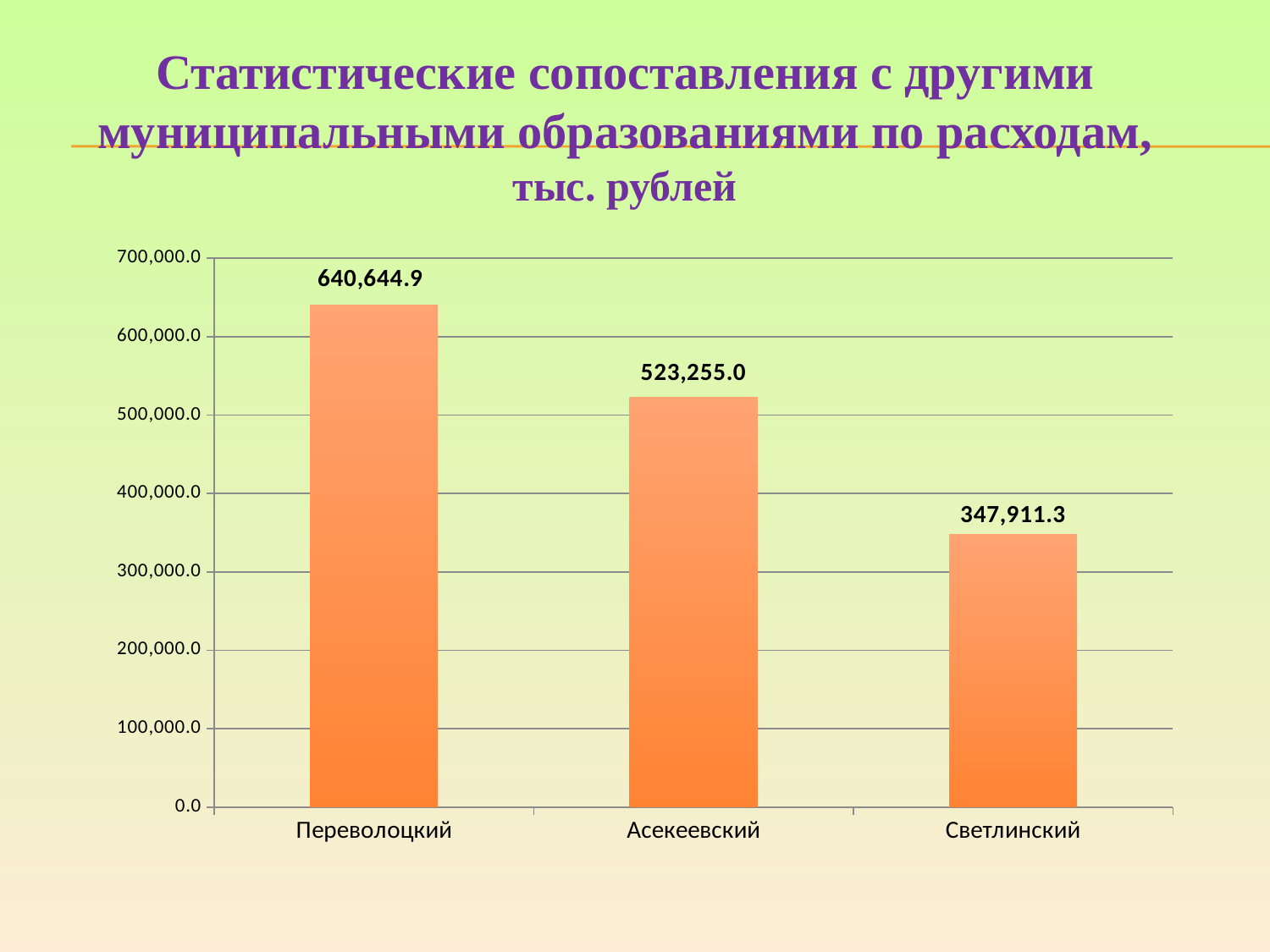
Do the values rise or fall from left to right along the x axis? fall Which is larger, the value for Асекеевский or the value for Светлинский? Асекеевский What is the value for Асекеевский? 523,255.0 What is the value for Светлинский? 347,911.3 How many municipalities are shown in the chart? 3 What is the value for Переволоцкий? 640,644.9 Which municipality has the highest expenditure? Переволоцкий What is the difference between the values for Асекеевский and Светлинский? 175,343.7 What kind of chart is shown on the slide? bar chart Is the value for Светлинский greater or less than 400,000.0? less Which municipality has the lowest expenditure? Светлинский What is the difference between the values for Переволоцкий and Асекеевский? 117,389.9